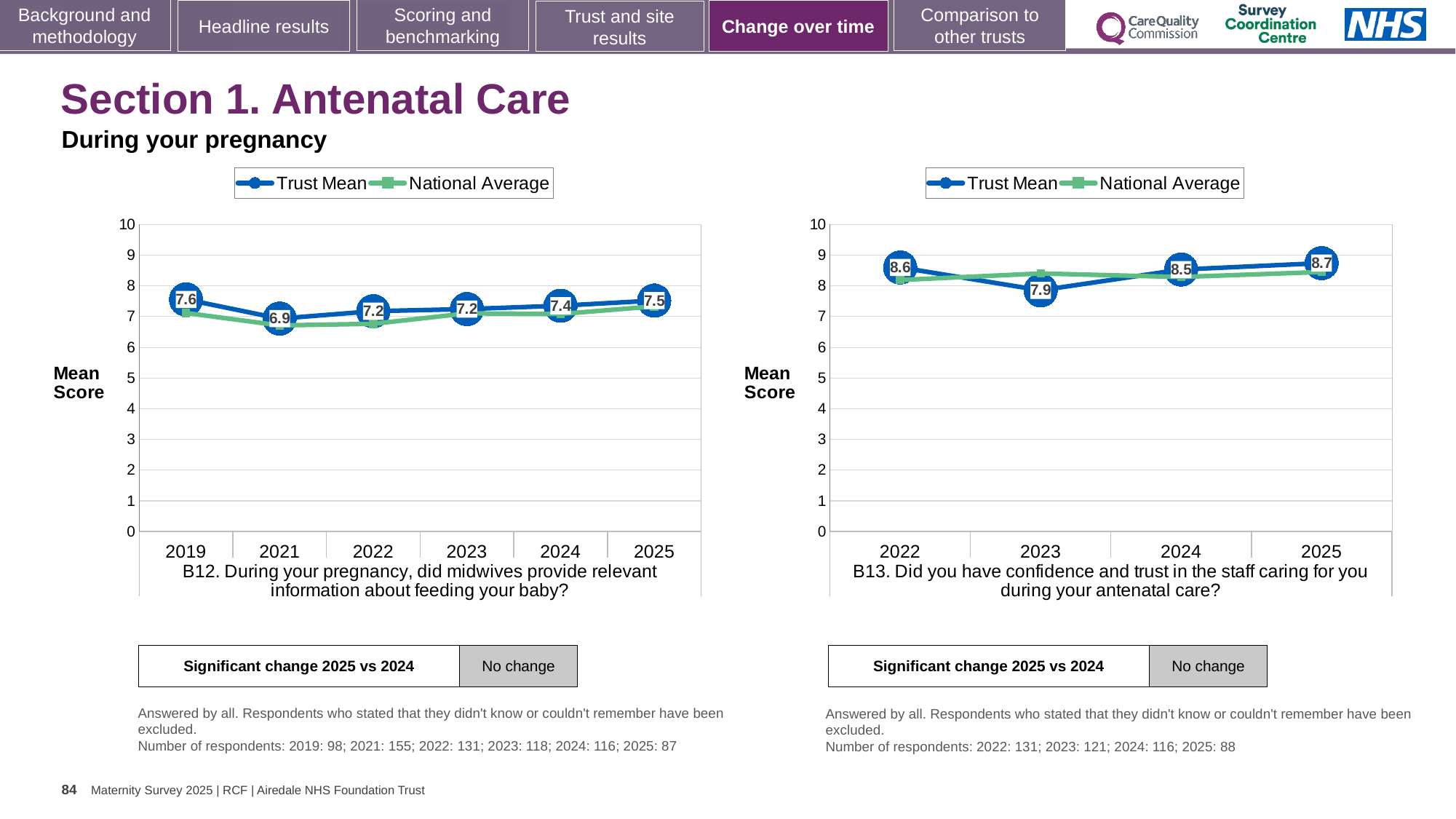
In the B12 chart (left), which year has the lowest Trust Mean? 2021 In the B12 chart (left), what is the Trust Mean for 2025? 7.5 In the B13 chart (right), is the Trust Mean for 2022 larger or smaller than the Trust Mean for 2023? larger In the B12 chart (left), how many years are shown on the x axis? 6 In the B13 chart (right), which year has the highest Trust Mean? 2025 What kind of chart is the B12 chart (left)? Line chart In the B12 chart (left), what is the Trust Mean for 2019? 7.6 In the B13 chart (right), what is the difference between the Trust Mean for 2025 and 2024? 0.2 In the B12 chart (left), what is the difference between the Trust Mean for 2019 and 2021? 0.7 In the B12 chart (left), which year has the highest Trust Mean? 2019 How many series does the legend of the B13 chart (right) list? 2 In the B13 chart (right), what is the Trust Mean for 2023? 7.9